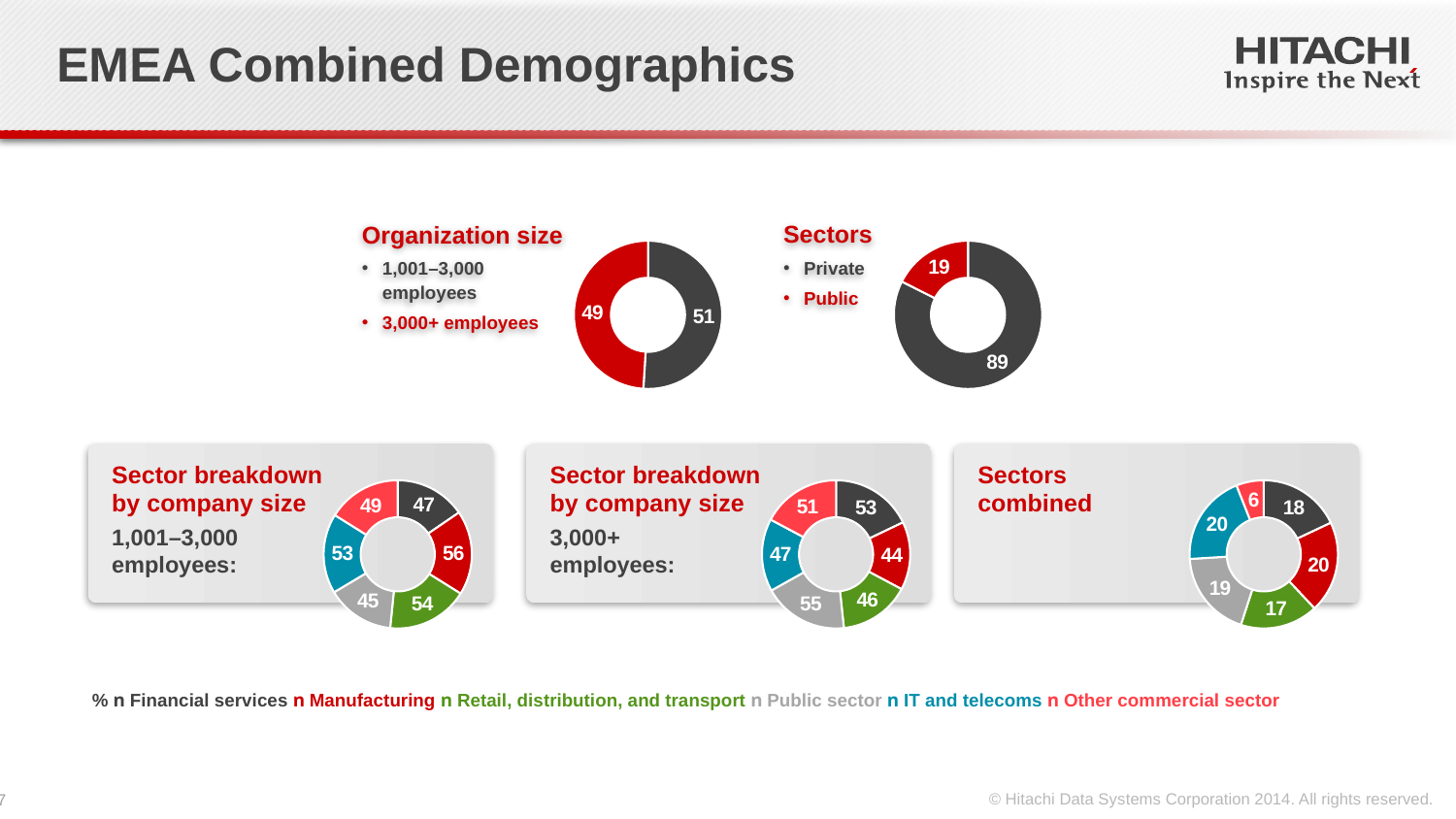
How many slices does the 'Sectors combined' chart have? 6 In the 'Sector breakdown by company size' chart for 3,000+ employees, which sector has the lowest value? Manufacturing In the 'Sector breakdown by company size' chart for 3,000+ employees, what is the difference between Financial services and Manufacturing? 9 In the 'Organization size' chart, what is the value for 3,000+ employees? 49 In the 'Sector breakdown by company size' chart for 1,001–3,000 employees, which sector has the lowest value? Public sector In the 'Sector breakdown by company size' chart for 1,001–3,000 employees, what is the value for Manufacturing? 56 In the 'Sector breakdown by company size' chart for 3,000+ employees, what is the value for Public sector? 55 What kind of chart is used for the 'Organization size' breakdown? doughnut chart How many sectors does the legend at the bottom of the slide list? 6 In the 'Sectors' chart, what is the value for Private? 89 In the 'Sector breakdown by company size' chart for 1,001–3,000 employees, which is larger, Financial services or Manufacturing? Manufacturing In the 'Sectors combined' chart, what is the value for Other commercial sector? 6